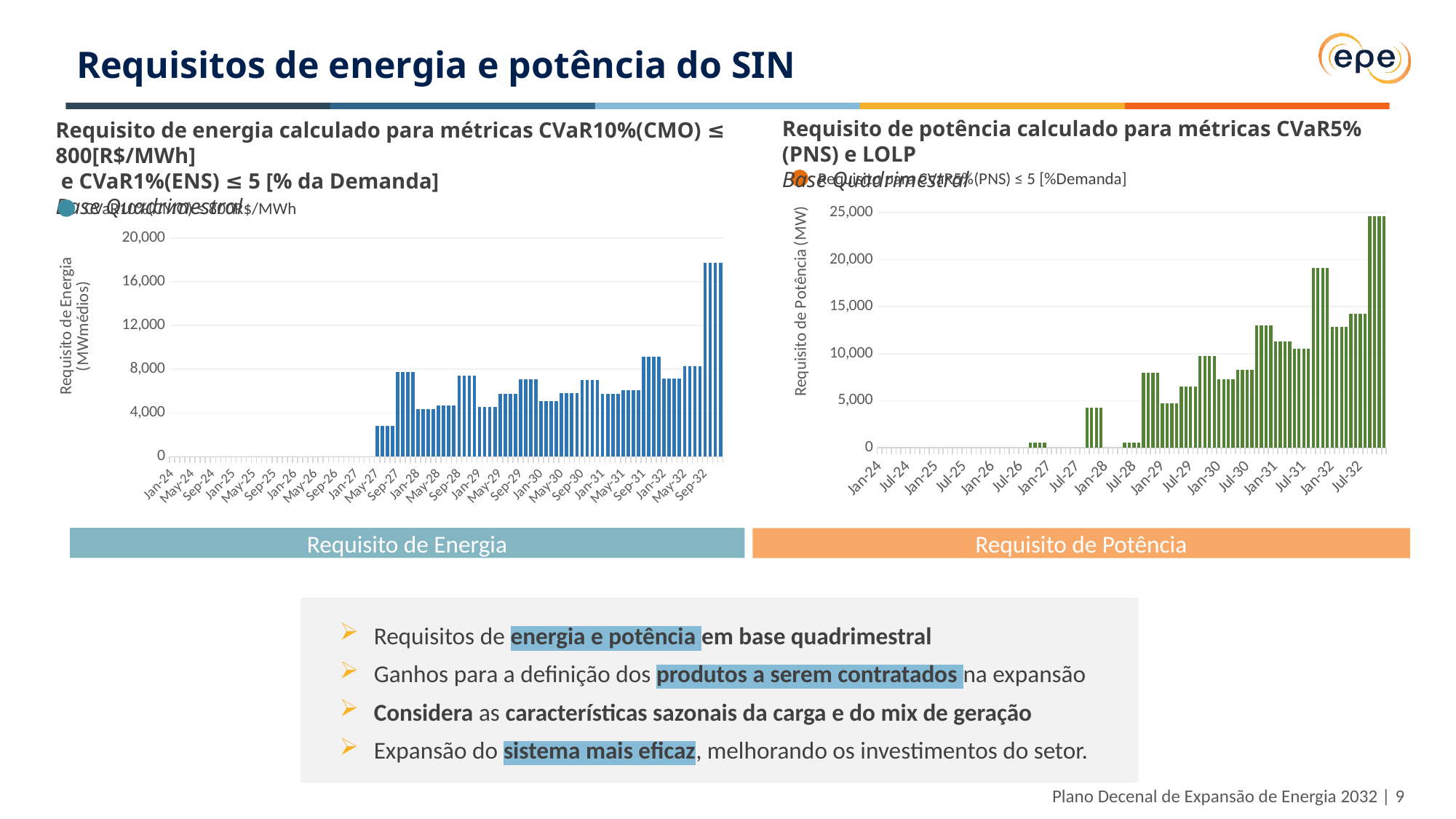
What type of chart is the Requisito de Potência chart on the right? bar chart In the Requisito de Potência chart on the right, is the value for Jan-32 greater or less than 15,000? less In the Requisito de Energia chart on the left, is the value for Sep-32 greater or less than 16,000? greater In the Requisito de Energia chart on the left, do the values generally rise or fall over the period shown? rise In the Requisito de Energia chart on the left, is the value for May-27 greater or less than 4,000? less What is the y-axis label of the Requisito de Potência chart on the right? Requisito de Potência (MW) What type of chart is the Requisito de Energia chart on the left? bar chart In the Requisito de Energia chart on the left, which period shows the highest bars? Sep-32 In the Requisito de Potência chart on the right, do the values generally rise or fall from Jan-24 to the end of 2032? rise